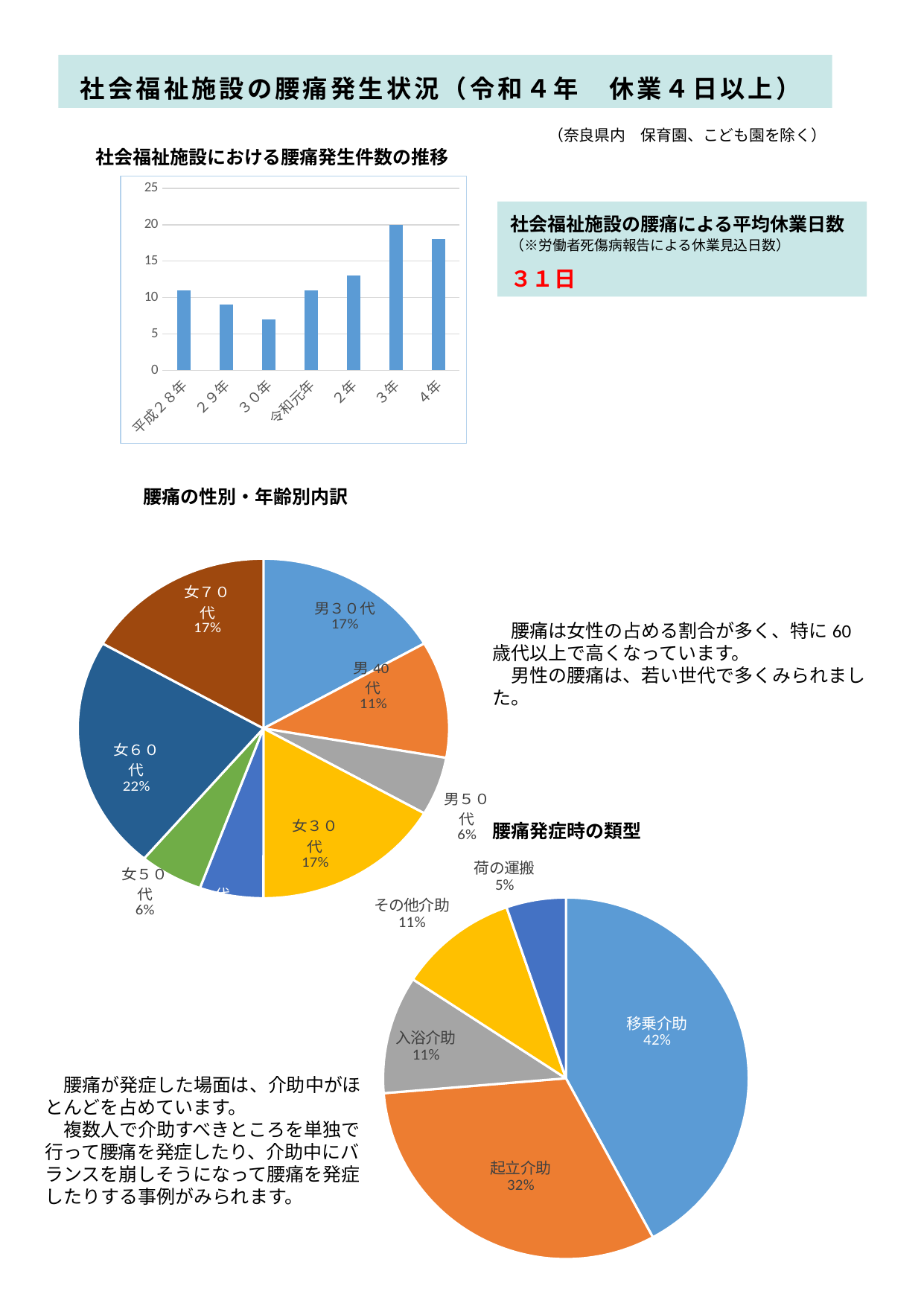
In the pie chart titled 腰痛発症時の類型, which slice is the smallest? 荷の運搬 In the chart titled 社会福祉施設における腰痛発生件数の推移, is the value for 4年 greater or less than 15? greater In the chart titled 社会福祉施設における腰痛発生件数の推移, which year has the highest value? 3年 In the pie chart titled 腰痛発症時の類型, what share does 移乗介助 have? 42% In the chart titled 社会福祉施設における腰痛発生件数の推移, what is the value for 3年? 20 In the pie chart titled 腰痛の性別・年齢別内訳, which slice is the largest? 女60代 In the pie chart titled 腰痛発症時の類型, what is the difference between the shares of 移乗介助 and 起立介助? 10% In the chart titled 社会福祉施設における腰痛発生件数の推移, which is larger, the value for 2年 or the value for 29年? 2年 What kind of chart is the chart titled 社会福祉施設における腰痛発生件数の推移? bar chart In the chart titled 社会福祉施設における腰痛発生件数の推移, which year has the lowest value? 30年 In the chart titled 社会福祉施設における腰痛発生件数の推移, how many years are shown on the x axis? 7 In the pie chart titled 腰痛の性別・年齢別内訳, what share does 女60代 have? 22%